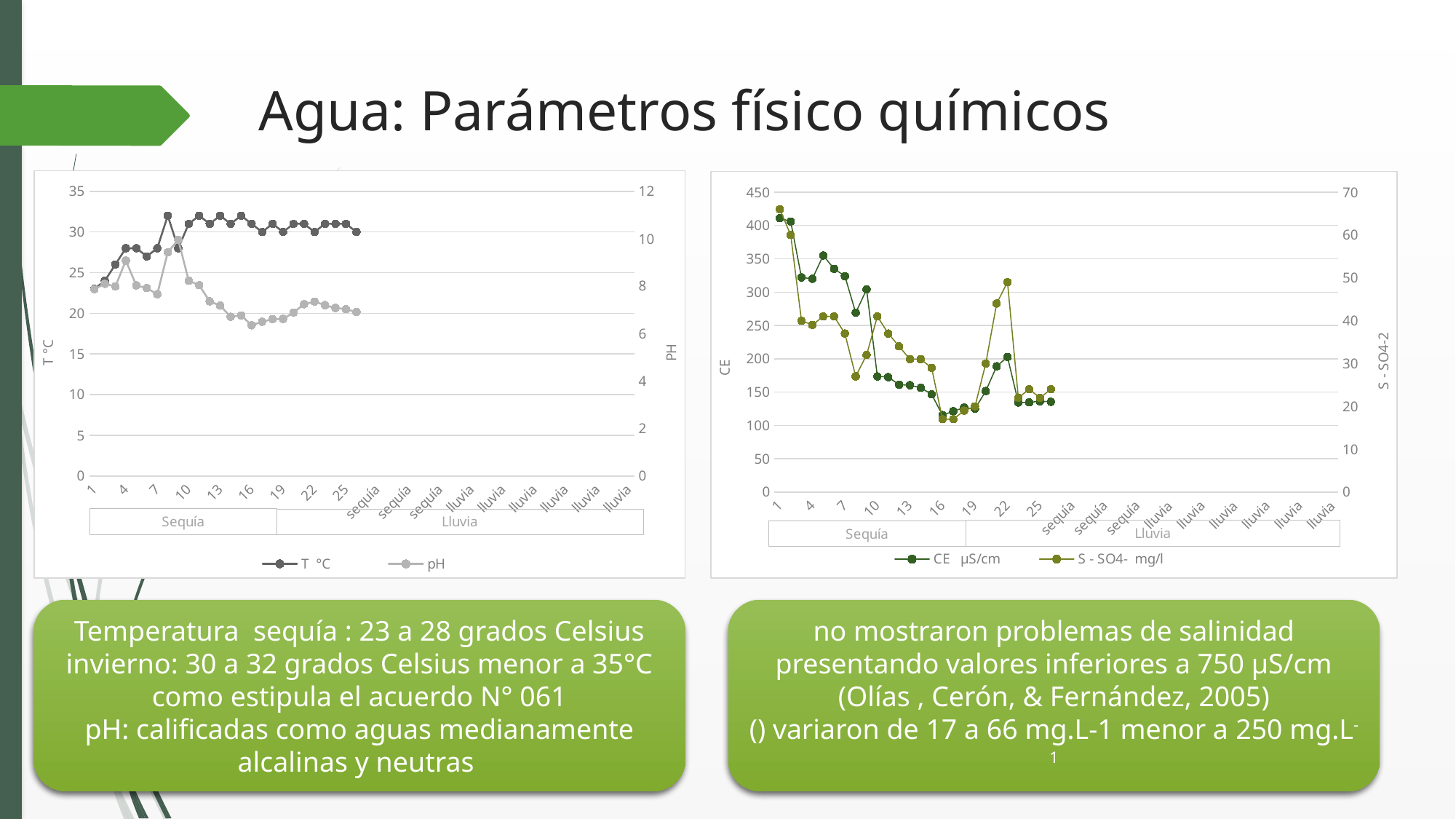
In the right chart, is the CE value at point 1 greater or less than 350? greater How many series does the legend of the right chart list? 2 In the left chart, does the T °C series overall rise or fall from the first point to the last point? rise How many series does the legend of the left chart list? 2 What are the two period labels shown beneath the x axis of the right chart? Sequía and Lluvia In the right chart, does the CE series overall rise or fall from the first point to the last point? fall In the left chart, is the pH value at point 16 greater or less than 8? less In the right chart, is the S - SO4 value at point 1 greater or less than 60? greater What kind of chart is the right chart showing CE and S - SO4? line chart What kind of chart is the left chart showing T °C and pH? line chart